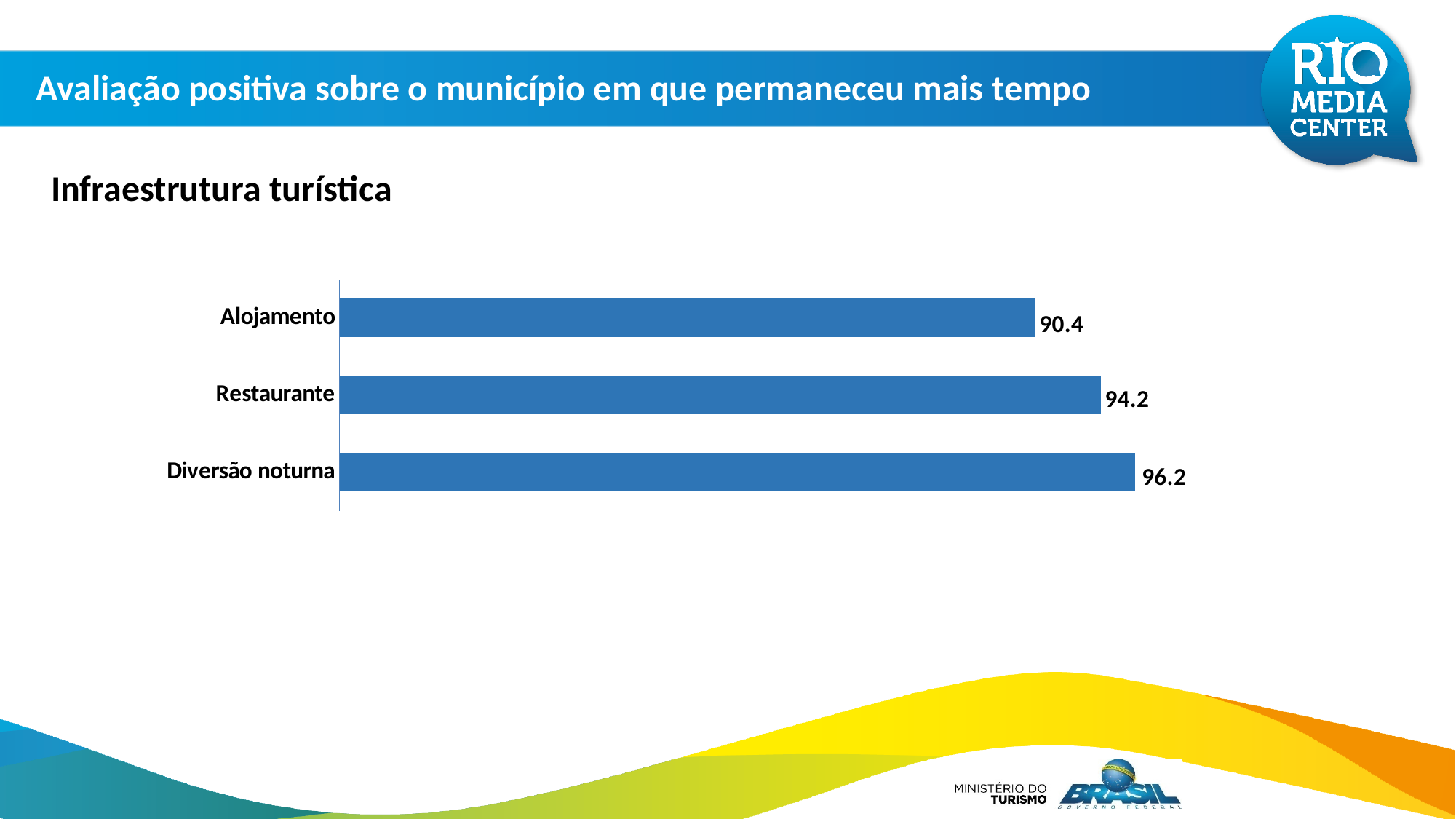
What is the difference between the values for Diversão noturna and Alojamento? 5.8 What is the heading above the chart? Infraestrutura turística Which category has the lowest value? Alojamento Which is larger, the value for Restaurante or the value for Alojamento? Restaurante Which category has the highest value? Diversão noturna What colour are the bars in the chart? Blue How many categories are shown in the chart? 3 What is the value for Restaurante? 94.2 What is the value for Alojamento? 90.4 What is the difference between the values for Restaurante and Alojamento? 3.8 What is the value for Diversão noturna? 96.2 What kind of chart is shown on the slide? Bar chart